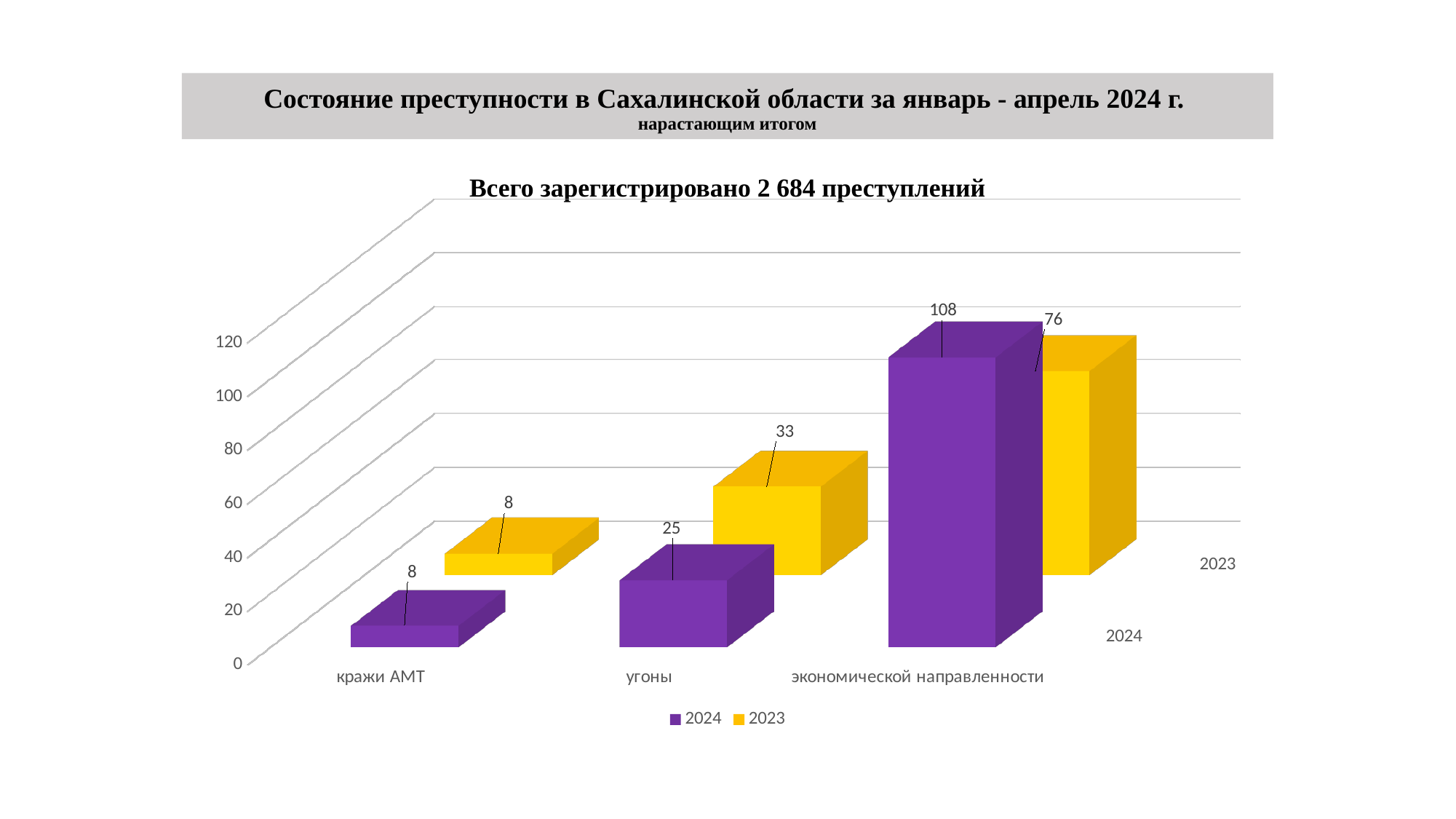
What is the value for экономической направленности in the 2024 series? 108 How many categories are shown on the x axis? 3 What is the title of the chart? Всего зарегистрировано 2 684 преступлений What is the value for угоны in the 2024 series? 25 For угоны, which series has the larger value, 2024 or 2023? 2023 What is the difference between the 2024 and 2023 values for экономической направленности? 32 What is the value for угоны in the 2023 series? 33 Which category has the highest value in the 2024 series? экономической направленности How many series does the legend list? 2 What is the value for кражи АМТ in the 2023 series? 8 Which category has the lowest value in the 2023 series? кражи АМТ What is the value for экономической направленности in the 2023 series? 76